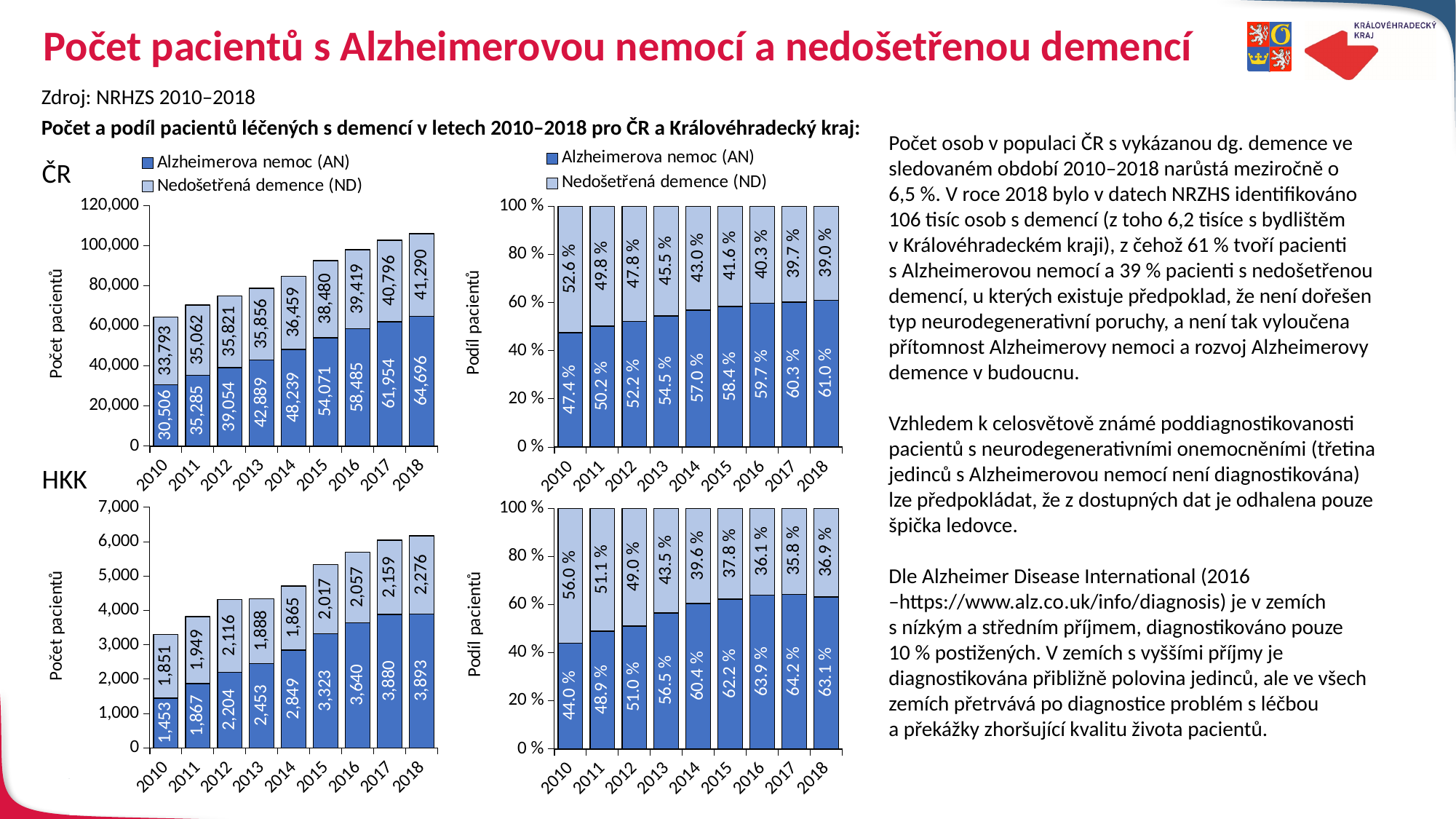
In the top-left chart (ČR, Počet pacientů), what is the value for Alzheimerova nemoc (AN) in 2018? 64,696 In the bottom-right chart (HKK, Podíl pacientů), what is the share of Alzheimerova nemoc (AN) in 2017? 64.2 % In the top-left chart (ČR, Počet pacientů), which year has the lowest value for Nedošetřená demence (ND)? 2010 In the bottom-right chart (HKK, Podíl pacientů), which is larger in 2010: the share of Alzheimerova nemoc (AN) or Nedošetřená demence (ND)? Nedošetřená demence (ND) In the top-left chart (ČR, Počet pacientů), what is the total number of patients in 2018 (AN plus ND)? 105,986 In the top-right chart (ČR, Podíl pacientů), what is the share of Nedošetřená demence (ND) in 2018? 39.0 % How many series does the legend of the top-left chart (ČR, Počet pacientů) list? 2 In the top-right chart (ČR, Podíl pacientů), does the share of Alzheimerova nemoc (AN) rise or fall from 2010 to 2018? rise In the bottom-left chart (HKK, Počet pacientů), which year has the highest value for Alzheimerova nemoc (AN)? 2018 In the top-left chart (ČR, Počet pacientů), what is the value for Nedošetřená demence (ND) in 2010? 33,793 In the bottom-left chart (HKK, Počet pacientů), what is the difference between Alzheimerova nemoc (AN) and Nedošetřená demence (ND) in 2013? 565 In the bottom-left chart (HKK, Počet pacientů), what is the value for Alzheimerova nemoc (AN) in 2015? 3,323